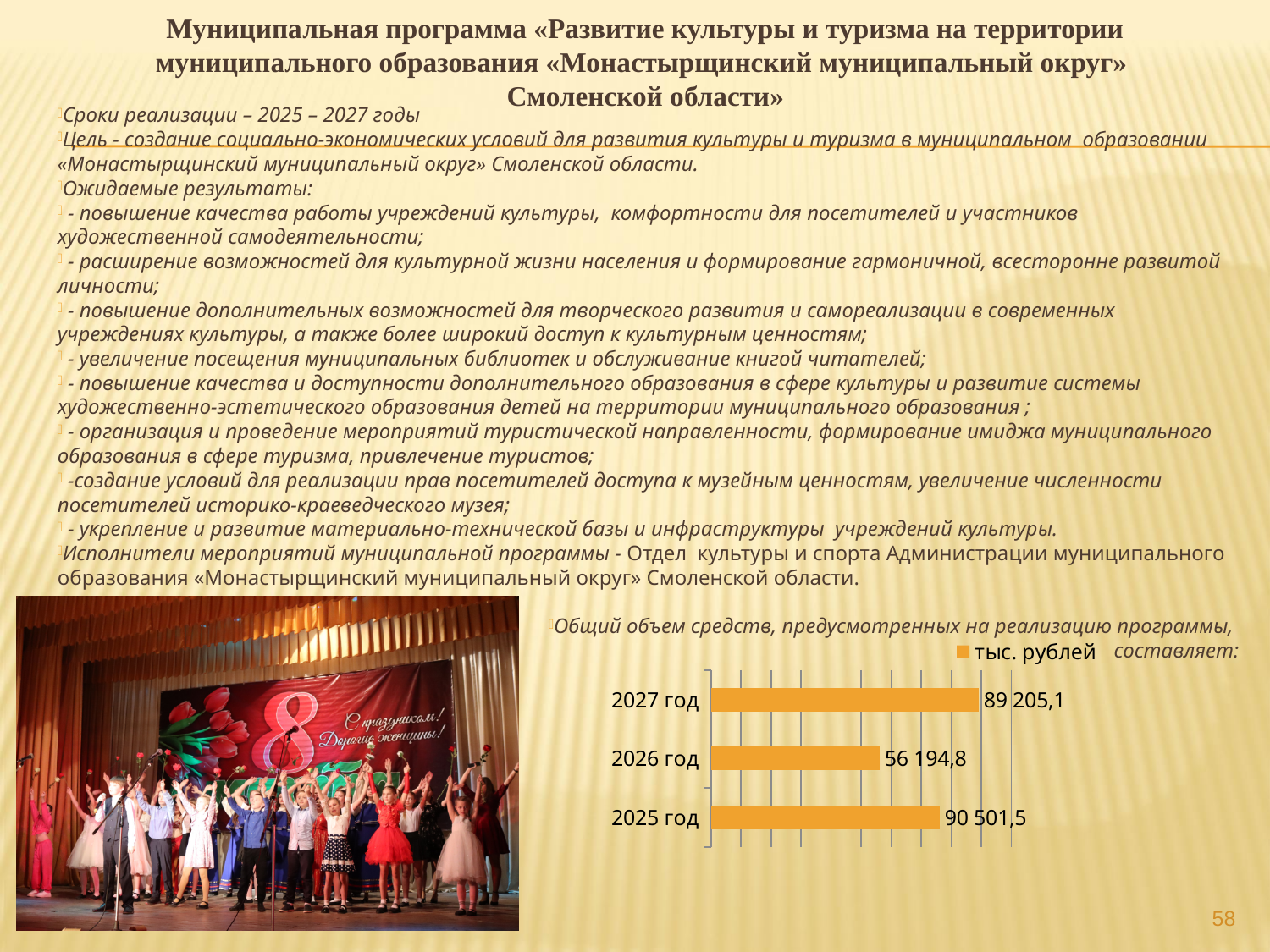
What is the value for 2027 год? 89 205,1 Which is larger, the value for 2027 год or the value for 2026 год? 2027 год What is the value for 2025 год? 90 501,5 How many series does the legend list? 1 What kind of chart is shown on the slide? bar chart What is the difference between the values for 2025 год and 2026 год? 34 306,7 What is the difference between the values for 2027 год and 2026 год? 33 010,3 Which year has the lowest value? 2026 год What is the legend entry of the chart? тыс. рублей How many years are shown in the chart? 3 What is the value for 2026 год? 56 194,8